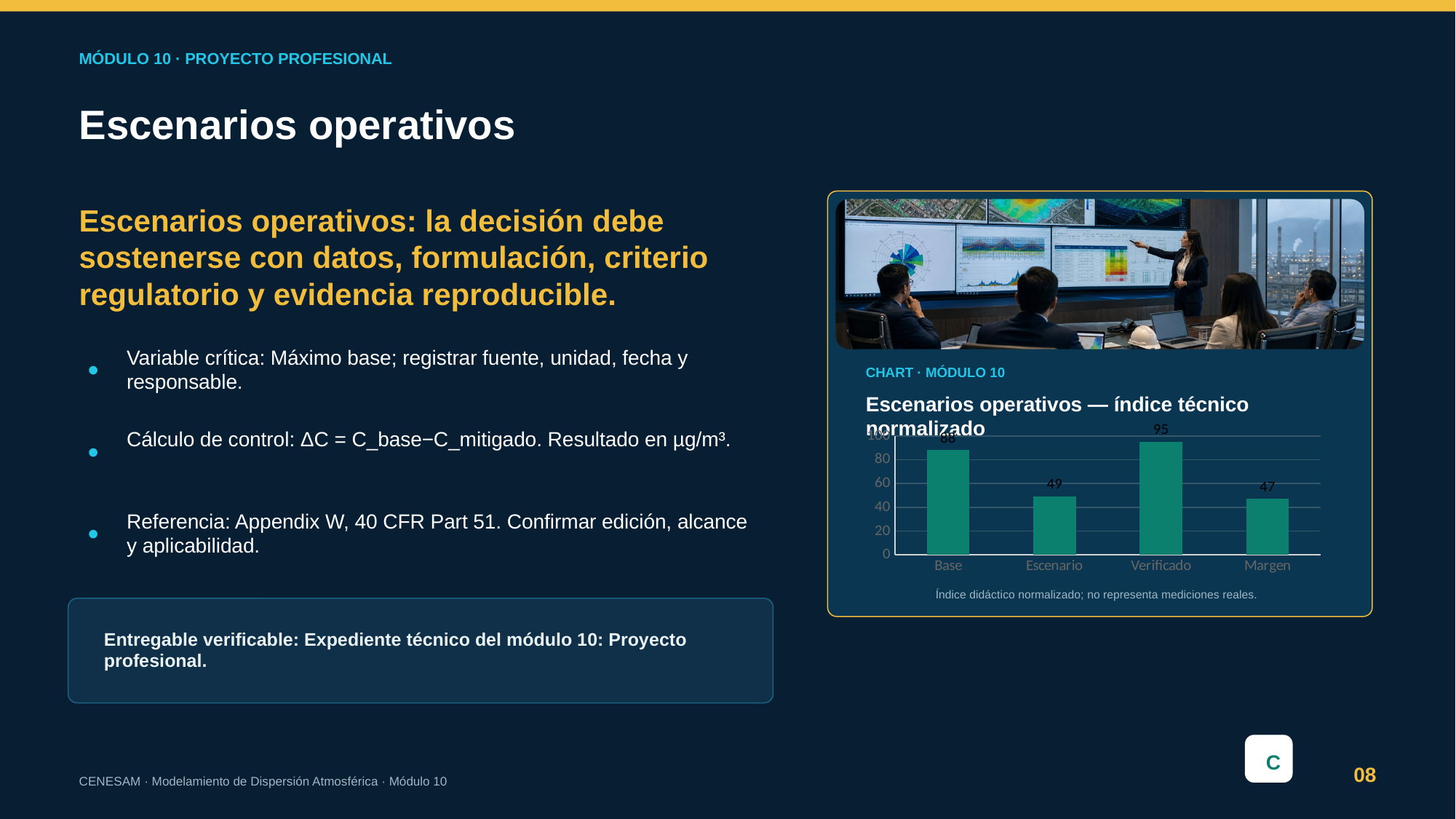
What is the value for Margen in the chart? 47 What is the value for Verificado in the chart? 95 What is the value for Escenario in the chart? 49 Which category has the highest value in the chart? Verificado What is the difference between the values for Base and Escenario? 39 Which is larger, the value for Escenario or the value for Margen? Escenario What is the value for Base in the chart? 88 What kind of chart is shown on the slide? Bar chart How many categories are shown on the x axis of the chart? 4 Is the value for Base greater or less than 80? greater What is the difference between the values for Verificado and Base? 7 Which category has the lowest value in the chart? Margen